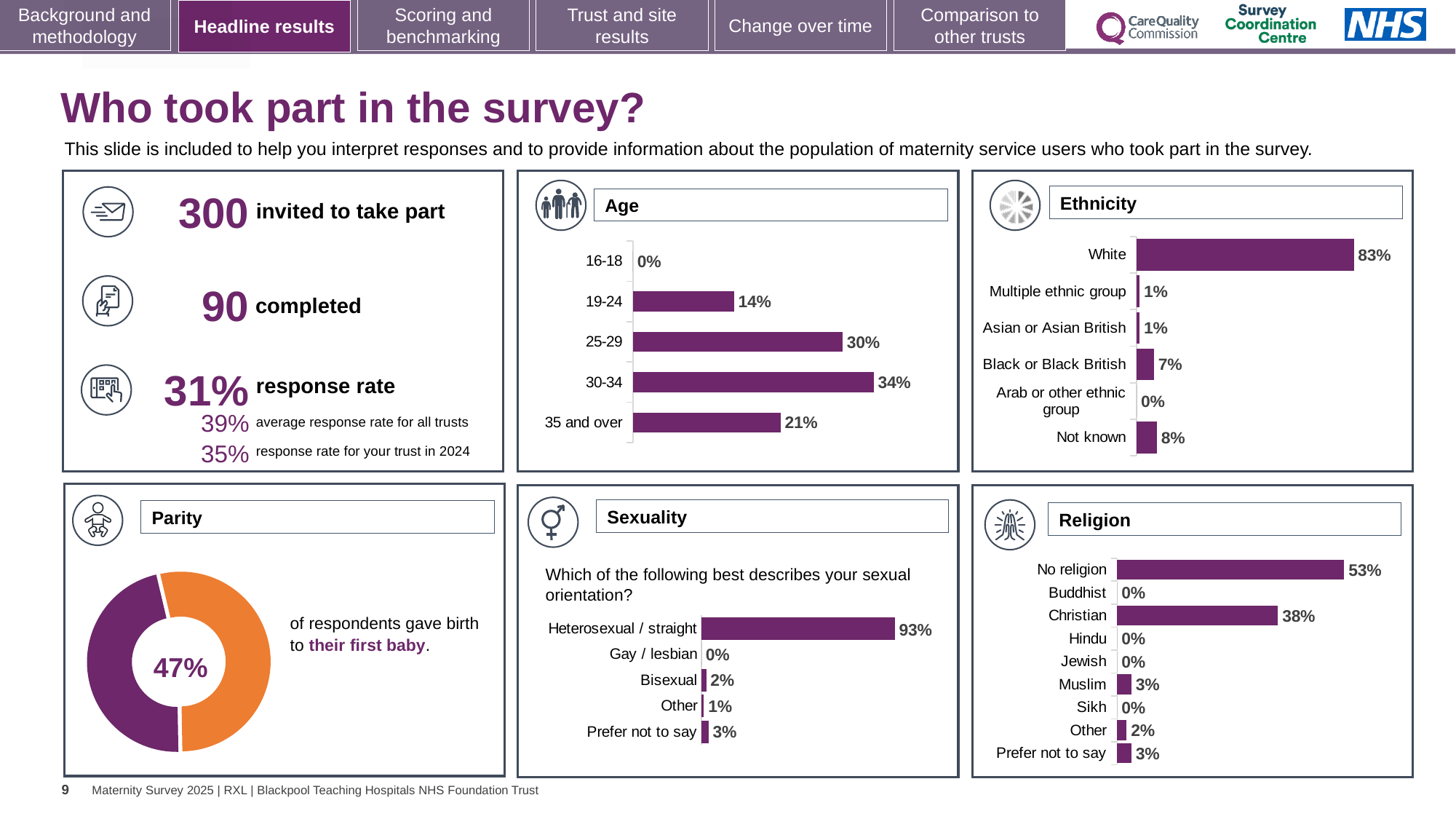
In the Religion chart, which category has the highest percentage? No religion How many categories are shown in the Religion chart? 9 In the Ethnicity chart, which is larger: Black or Black British or Not known? Not known In the Age chart, what is the difference between the 25-29 and 19-24 percentages? 16% In the Sexuality chart, what percentage of respondents answered Heterosexual / straight? 93% In the Age chart, what percentage of respondents were aged 30-34? 34% In the Ethnicity chart, what percentage of respondents were White? 83% In the Age chart, which age group has the highest percentage? 30-34 How many age groups are shown in the Age chart? 5 In the Sexuality chart, what is the difference between Prefer not to say and Bisexual? 1% In the Parity chart, what share of respondents gave birth to their first baby? 47% What kind of chart is the Parity chart? Donut (pie) chart